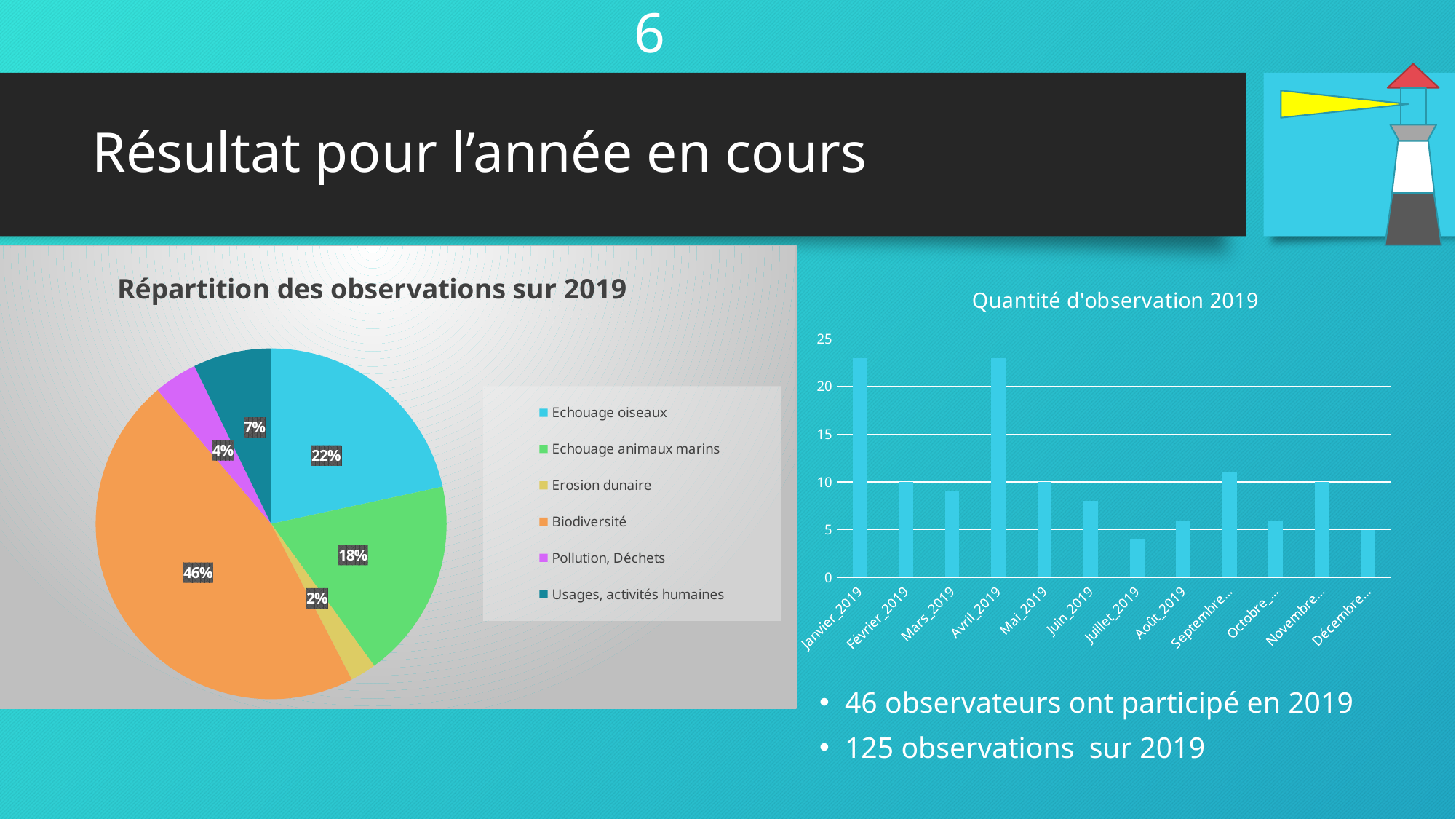
In the chart 'Quantité d'observation 2019', is the value for Juin_2019 greater or less than 10? less In the pie chart 'Répartition des observations sur 2019', which category has the smallest share? Erosion dunaire How many categories does the legend of the pie chart 'Répartition des observations sur 2019' list? 6 In the chart 'Quantité d'observation 2019', is the value for Juillet_2019 greater or less than 5? less In the pie chart 'Répartition des observations sur 2019', which is larger: Echouage oiseaux or Echouage animaux marins? Echouage oiseaux In the pie chart 'Répartition des observations sur 2019', which category has the largest share? Biodiversité How many months are shown on the x axis of the chart 'Quantité d'observation 2019'? 12 In the pie chart 'Répartition des observations sur 2019', what percentage is shown for Biodiversité? 46% What kind of chart is 'Quantité d'observation 2019'? Bar chart In the pie chart 'Répartition des observations sur 2019', what percentage is shown for Echouage oiseaux? 22% In the pie chart 'Répartition des observations sur 2019', what is the difference in percentage points between Biodiversité and Echouage oiseaux? 24 In the chart 'Quantité d'observation 2019', is the value for Janvier_2019 greater or less than 20? greater